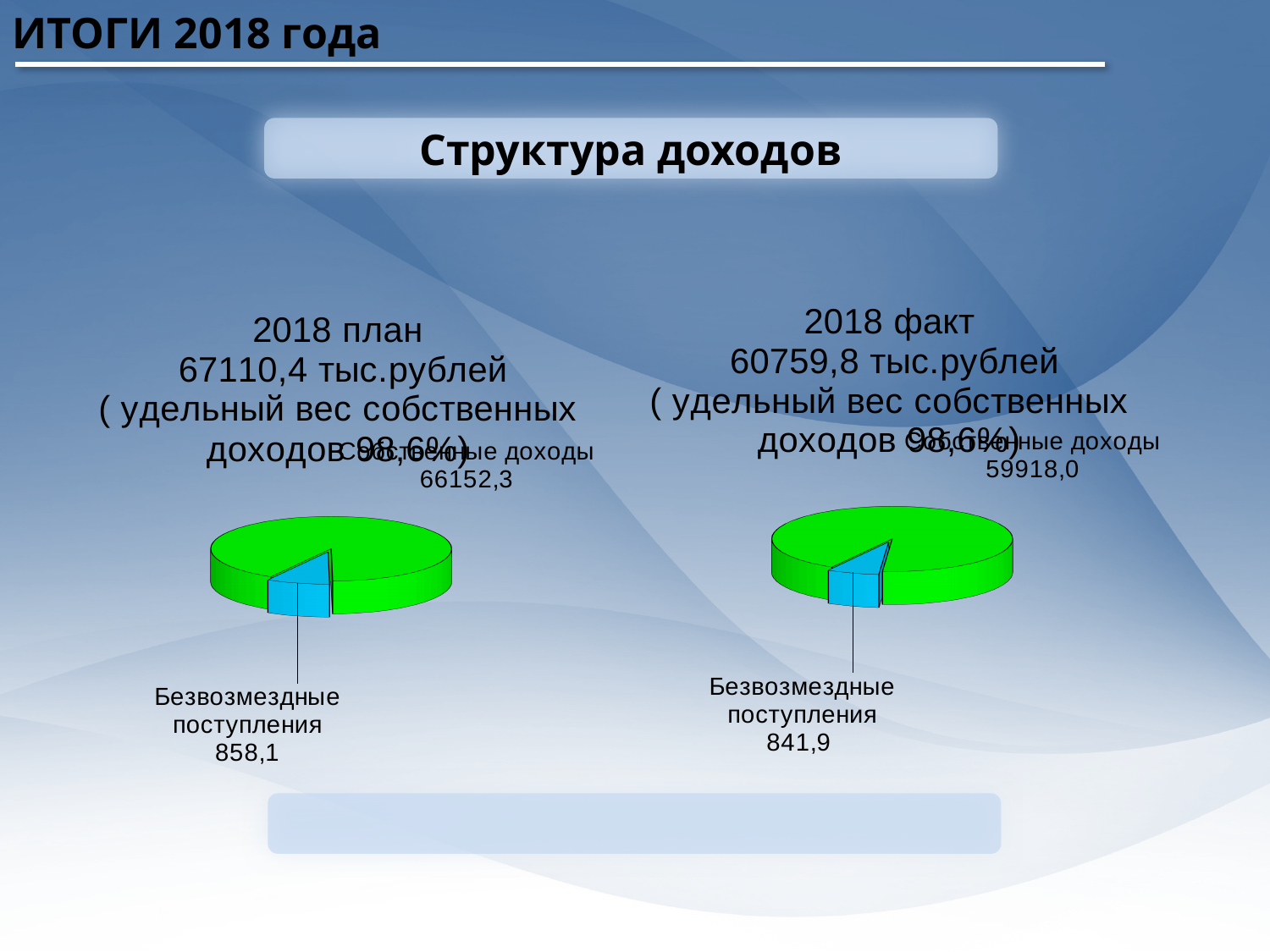
In the left pie chart (2018 план), what is the difference between Собственные доходы and Безвозмездные поступления? 65294,2 What colour is the Собственные доходы slice in the right pie chart (2018 факт)? Green What is the difference between Собственные доходы in the 2018 план chart and in the 2018 факт chart? 6234,3 What type of chart is used on the left (2018 план)? Pie chart In the right pie chart (2018 факт), which category has the smallest slice? Безвозмездные поступления In the left pie chart (2018 план), which category has the largest slice? Собственные доходы In the right pie chart (2018 факт), what is the value for Безвозмездные поступления? 841,9 How many slices does the right pie chart (2018 факт) have? 2 In the left pie chart (2018 план), what is the value for Собственные доходы? 66152,3 In the left pie chart (2018 план), what is the value for Безвозмездные поступления? 858,1 In the right pie chart (2018 факт), what is the value for Собственные доходы? 59918,0 Which is larger: Безвозмездные поступления in the 2018 план chart or in the 2018 факт chart? 2018 план